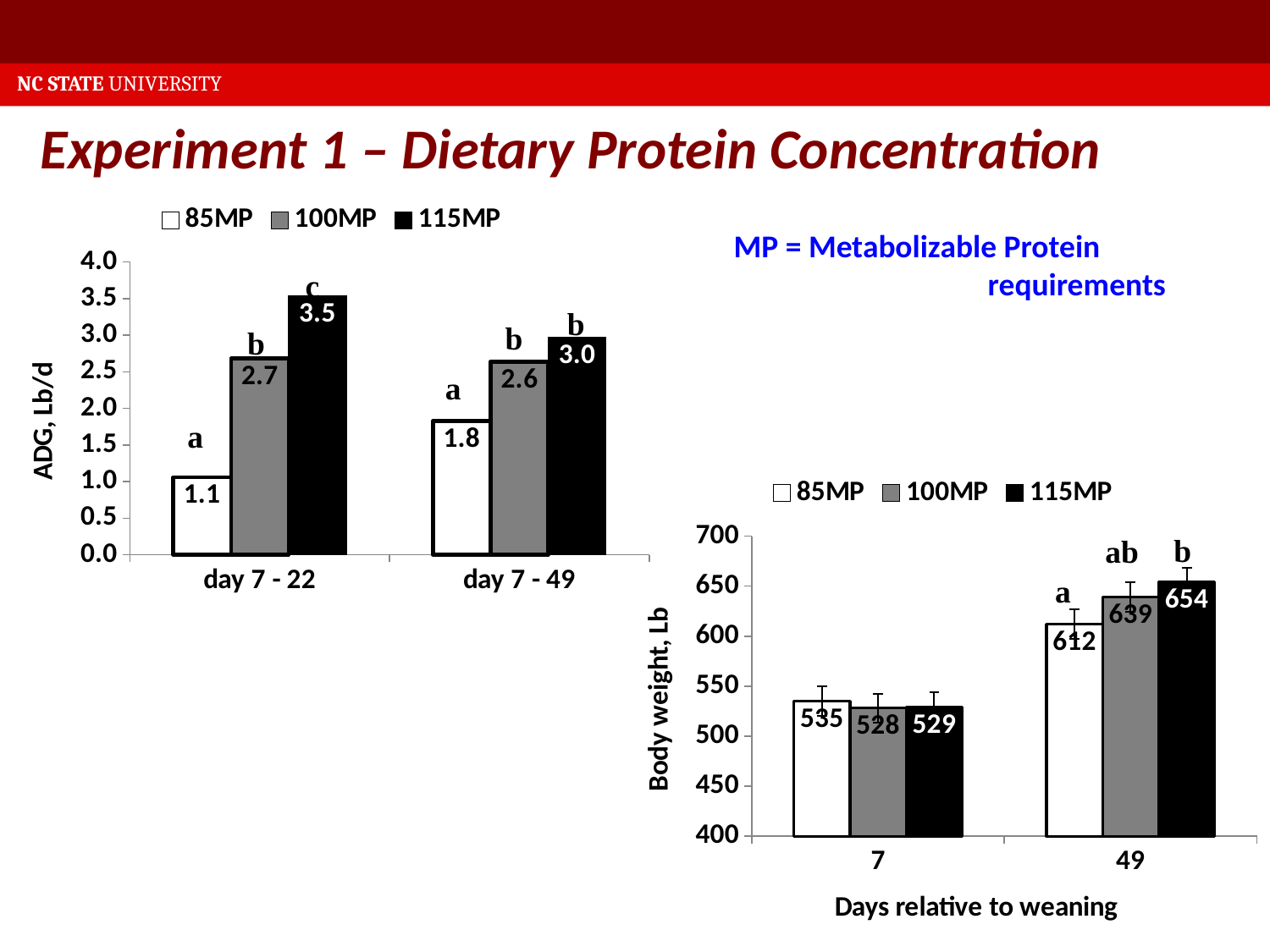
In the left chart (ADG, Lb/d), which series has the lowest value at day 7 - 22? 85MP In the right chart (Body weight, Lb), what is the value for 115MP at day 49? 654 In the left chart (ADG, Lb/d), is the 100MP value at day 7 - 49 larger or smaller than the 100MP value at day 7 - 22? smaller In the right chart (Body weight, Lb), what is the difference between the 115MP and 85MP values at day 49? 42 In the left chart (ADG, Lb/d), what is the difference between the 115MP and 85MP values at day 7 - 22? 2.4 What is the x-axis title of the right chart (Body weight, Lb)? Days relative to weaning In the left chart (ADG, Lb/d), what is the value for 115MP at day 7 - 22? 3.5 In the right chart (Body weight, Lb), which series has the highest value at day 49? 115MP How many series does the legend of the left chart (ADG, Lb/d) list? 3 In the right chart (Body weight, Lb), what is the value for 100MP at day 7? 528 In the left chart (ADG, Lb/d), what is the value for 85MP at day 7 - 49? 1.8 What kind of chart is the right chart (Body weight, Lb)? bar chart